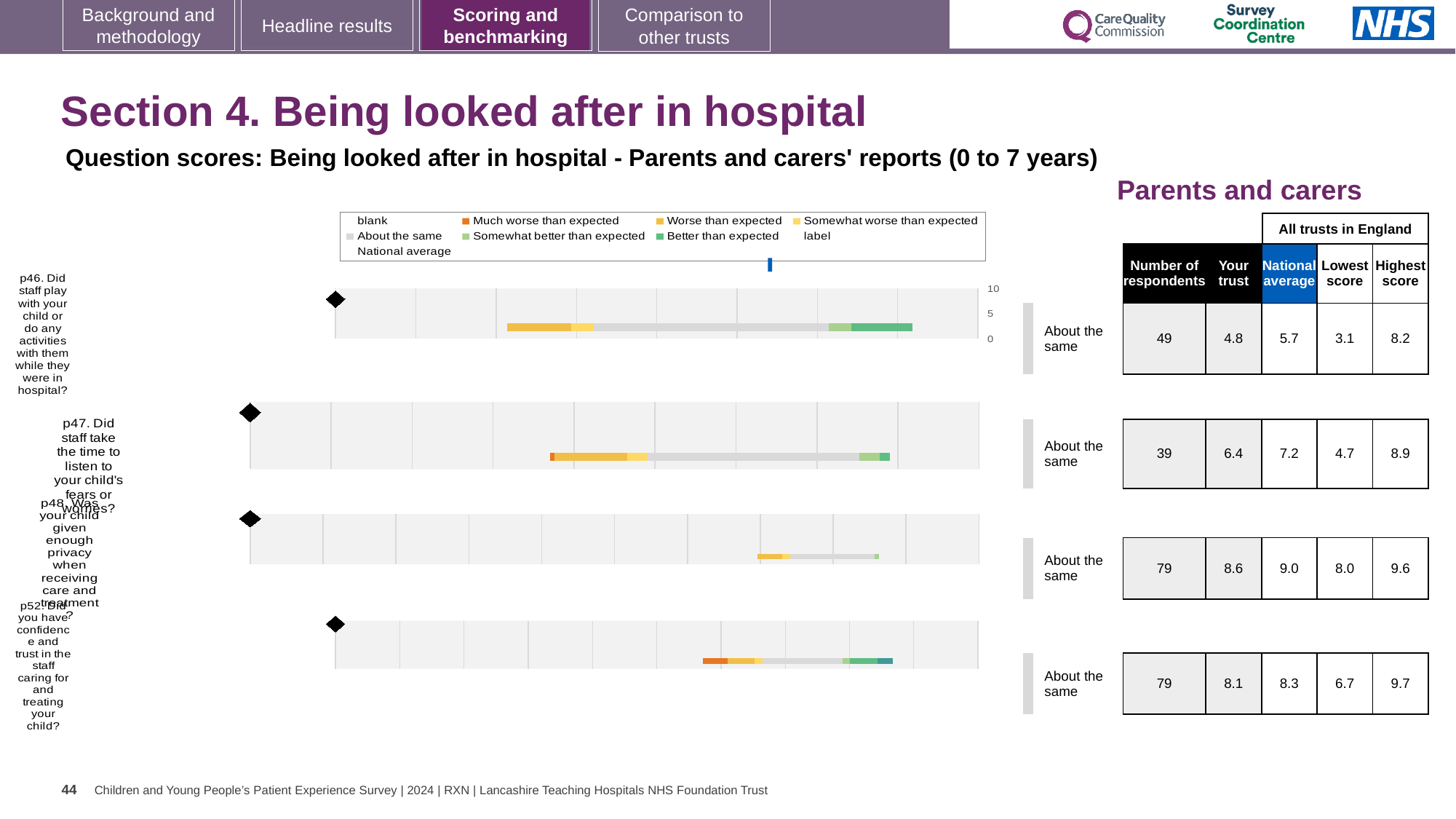
How many respondents answered p52 (Did you have confidence and trust in the staff caring for and treating your child?)? 79 In the legend, which category is shown in grey? About the same How many question score charts are shown on the slide? 4 What is the national average for p47 (Did staff take the time to listen to your child's fears or worries?)? 7.2 What is the difference between the national average and the 'Your trust' score for p46? 0.9 What benchmark category is the trust placed in for p52? About the same Which question has the lowest 'Your trust' score? p46 What kind of chart is used to show the question scores on this slide? bar chart For p47, which is larger: the 'Your trust' score or the national average? National average What is the highest score across all trusts in England for p48 (Was your child given enough privacy when receiving care and treatment?)? 9.6 Which question has the highest 'Your trust' score? p48 What is the 'Your trust' score for p46 (Did staff play with your child or do any activities with them while they were in hospital?)? 4.8